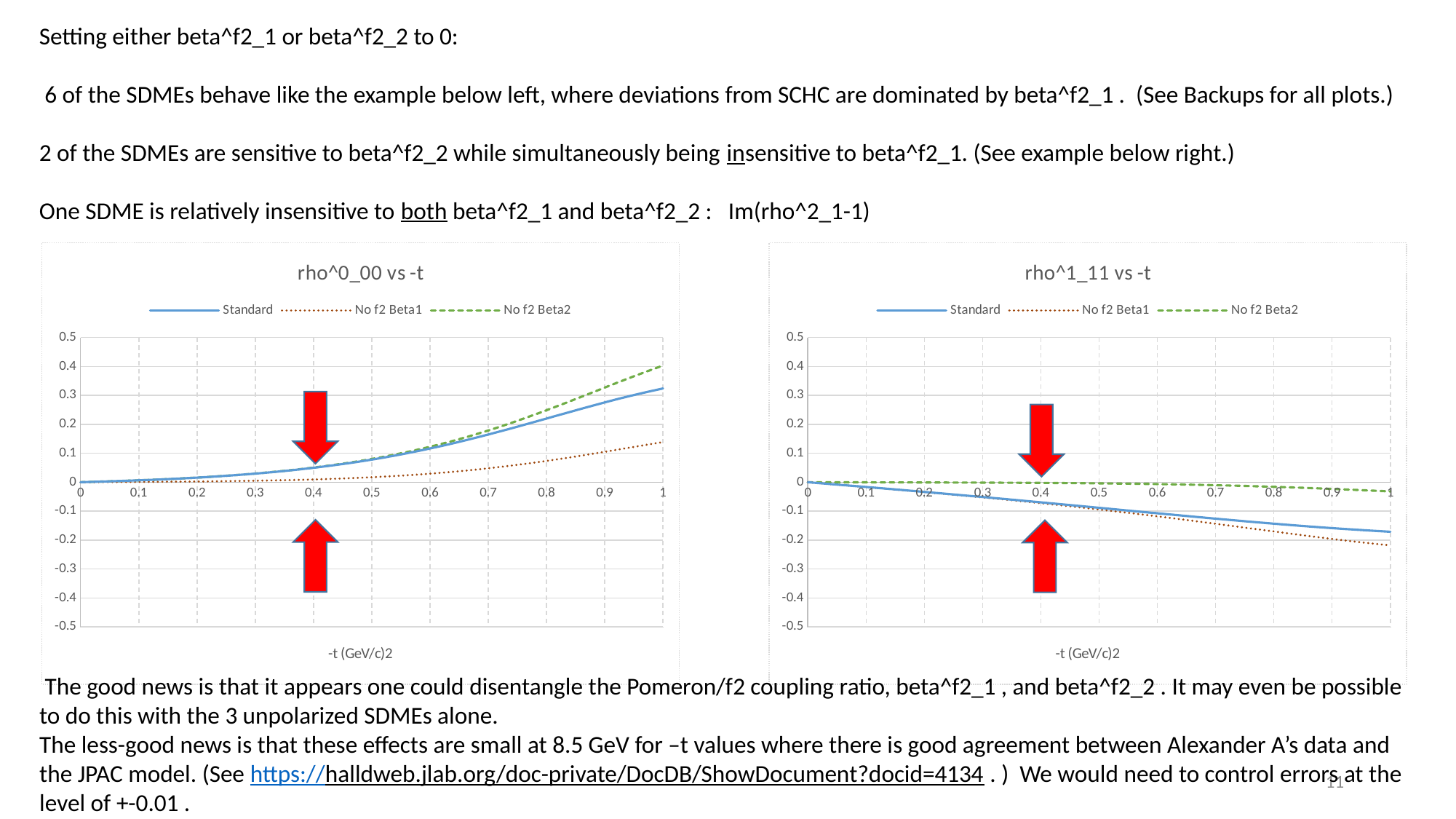
What is the x-axis label on the right chart "rho^1_11 vs -t"? -t (GeV/c)2 How many series does the legend of the right chart "rho^1_11 vs -t" list? 3 In the left chart "rho^0_00 vs -t", is the No f2 Beta2 value at -t = 1 greater or less than 0.3? greater In the right chart "rho^1_11 vs -t", which series has the higher value at -t = 1, Standard or No f2 Beta2? No f2 Beta2 In the right chart "rho^1_11 vs -t", is the Standard value at -t = 1 greater or less than -0.1? less In the left chart "rho^0_00 vs -t", is the Standard value at -t = 1 greater or less than 0.2? greater In the right chart "rho^1_11 vs -t", does the Standard series rise or fall as -t increases? fall What are the three legend entries on the left chart "rho^0_00 vs -t"? Standard, No f2 Beta1, No f2 Beta2 In the left chart "rho^0_00 vs -t", does the Standard series rise or fall as -t increases? rise In the left chart "rho^0_00 vs -t", which series has the higher value at -t = 1, No f2 Beta1 or No f2 Beta2? No f2 Beta2 What kind of chart is the left chart titled "rho^0_00 vs -t"? line chart